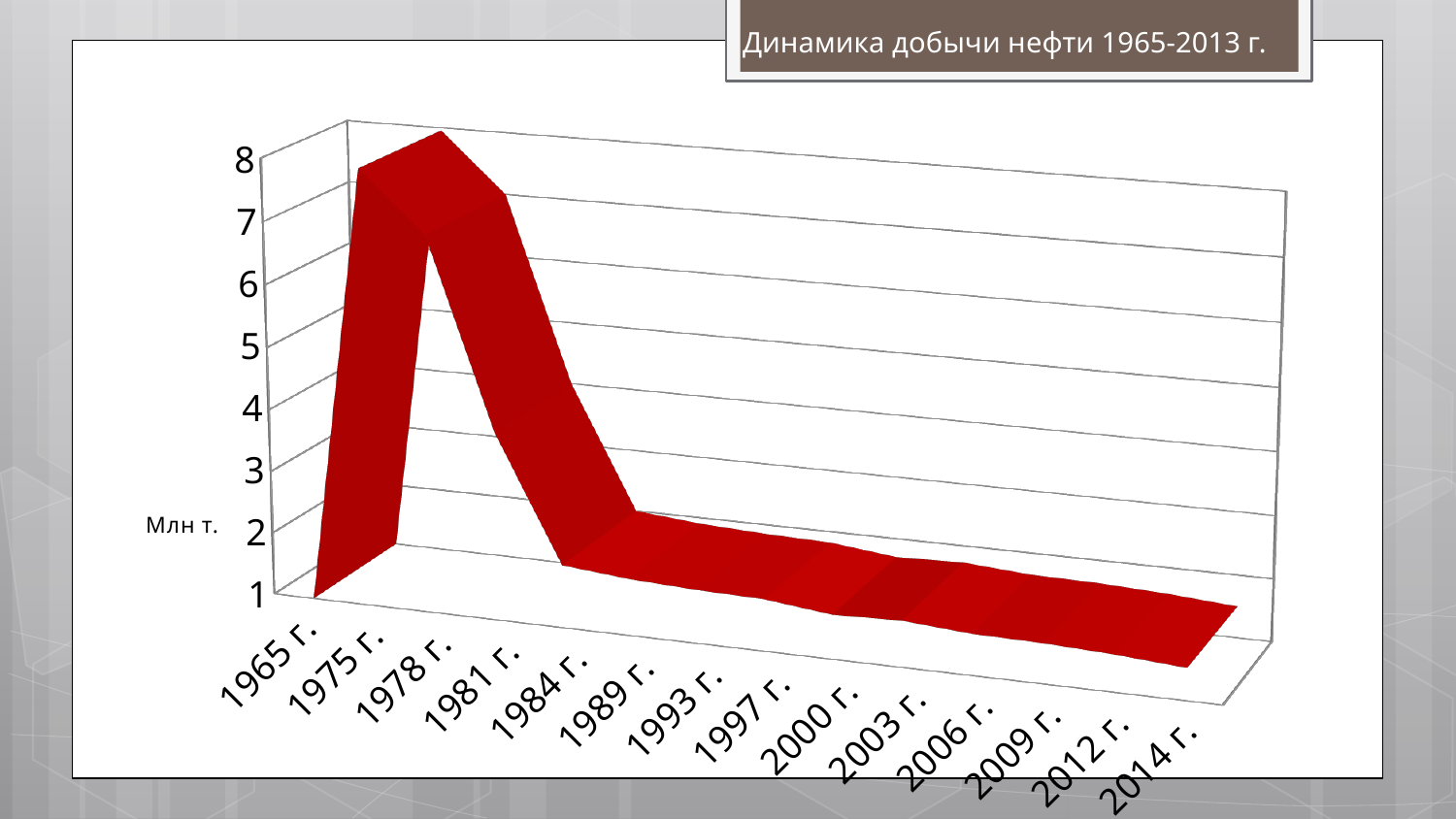
Which is larger, the value for 1978 г. or the value for 1984 г.? 1978 г. Do the values rise or fall from 1978 г. to 1984 г.? fall Which is larger, the value for 1975 г. or the value for 2000 г.? 1975 г. What kind of chart is shown on the slide? 3D line chart Is the value for 1978 г. greater or less than 5? greater Is the value for 1965 г. greater or less than 2? less What is the title of the chart? Динамика добычи нефти 1965-2013 г. Which year has the highest oil production value in the chart? 1975 г. Is the value for 2014 г. greater or less than 3? less How many year categories are shown on the x axis of the chart? 14 What unit label is shown on the vertical axis of the chart? Млн т.